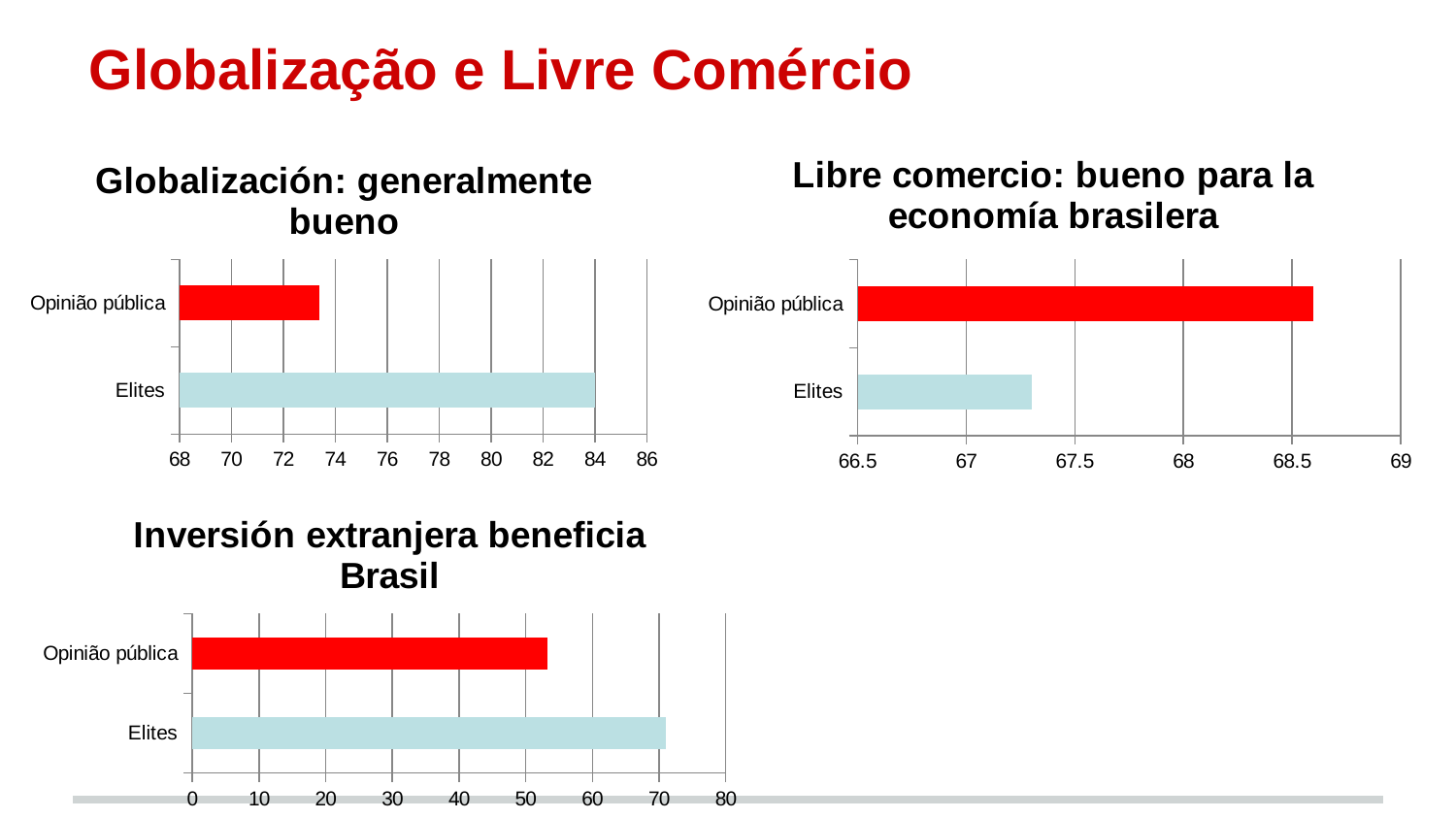
In the chart titled "Inversión extranjera beneficia Brasil", is the value for Opinião pública greater or less than 60? less How many categories are shown in the chart titled "Inversión extranjera beneficia Brasil"? 2 In the chart titled "Libre comercio: bueno para la economía brasilera", is the value for Opinião pública greater or less than 68? greater In the chart titled "Globalización: generalmente bueno", is the value for Elites greater or less than 80? greater In the chart titled "Globalización: generalmente bueno", which category has the higher value? Elites What kind of chart is the chart titled "Libre comercio: bueno para la economía brasilera"? Bar chart In the chart titled "Inversión extranjera beneficia Brasil", which category has the higher value? Elites In the chart titled "Libre comercio: bueno para la economía brasilera", which category has the lower value? Elites In the chart titled "Globalización: generalmente bueno", what colour is the bar for Opinião pública? Red